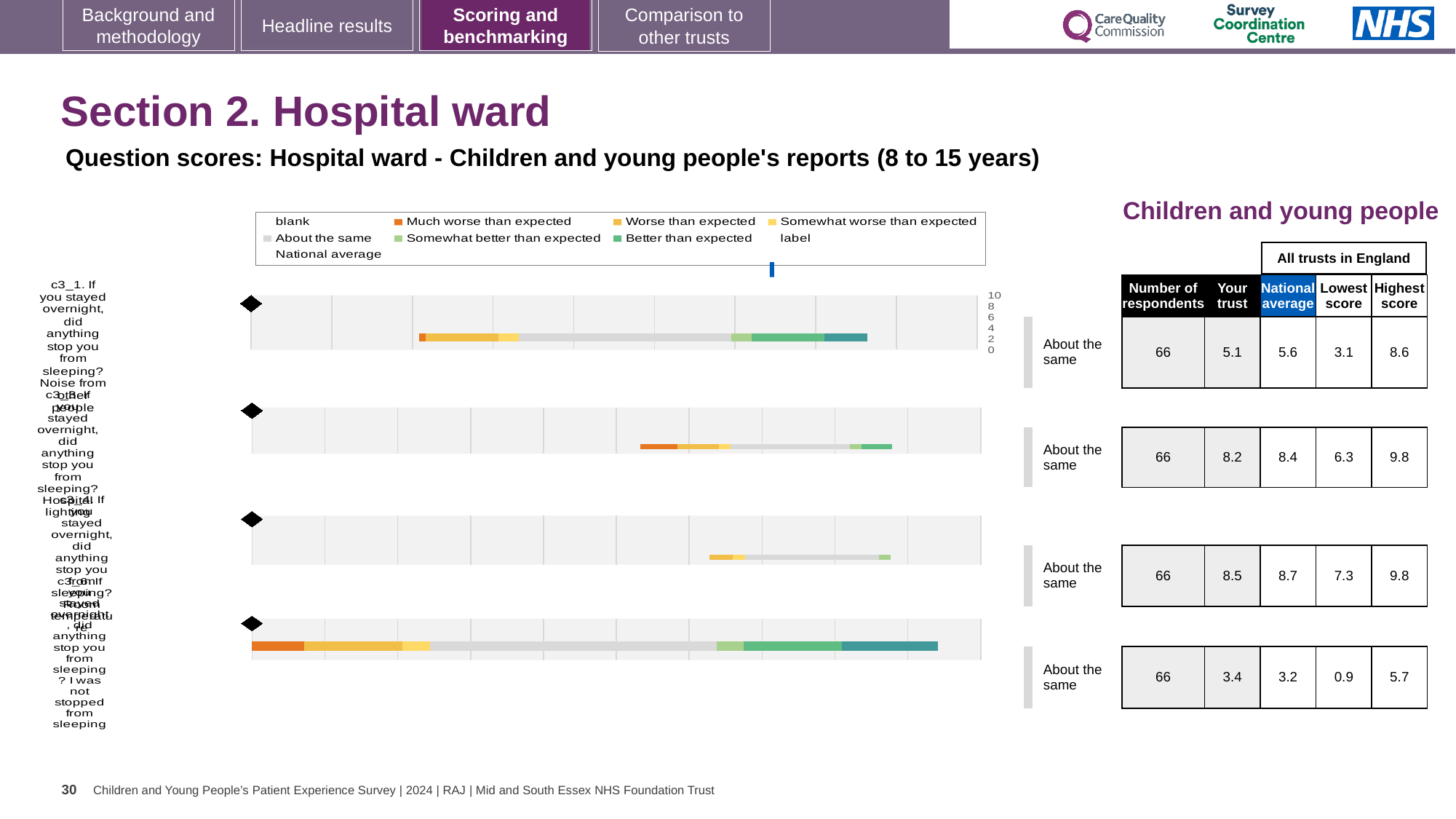
According to the table beside the top chart (c3_1, noise from other people), what is the 'Your trust' score? 5.1 In the chart legend, what colour represents 'Better than expected'? teal In the chart legend, what colour represents 'Much worse than expected'? orange What kind of chart is used for the four question rows on this slide? bar chart For the bottom chart (c3_6, I was not stopped from sleeping), which is larger: the 'Your trust' score or the national average? Your trust Which of the four question rows has the lowest 'Your trust' score? the bottom row (c3_6, I was not stopped from sleeping), 3.4 How many question rows (bars) are plotted on the slide? 4 For the top chart (c3_1), what is the difference between the highest score and the lowest score across all trusts in England? 5.5 What benchmark category label is shown next to each of the four charts? About the same How many respondents are listed for each of the four question rows? 66 According to the table beside the second chart (c3_3, hospital lighting), what is the national average score? 8.4 Which of the four question rows has the highest 'Your trust' score? the third row (c3_4, room temperature), 8.5